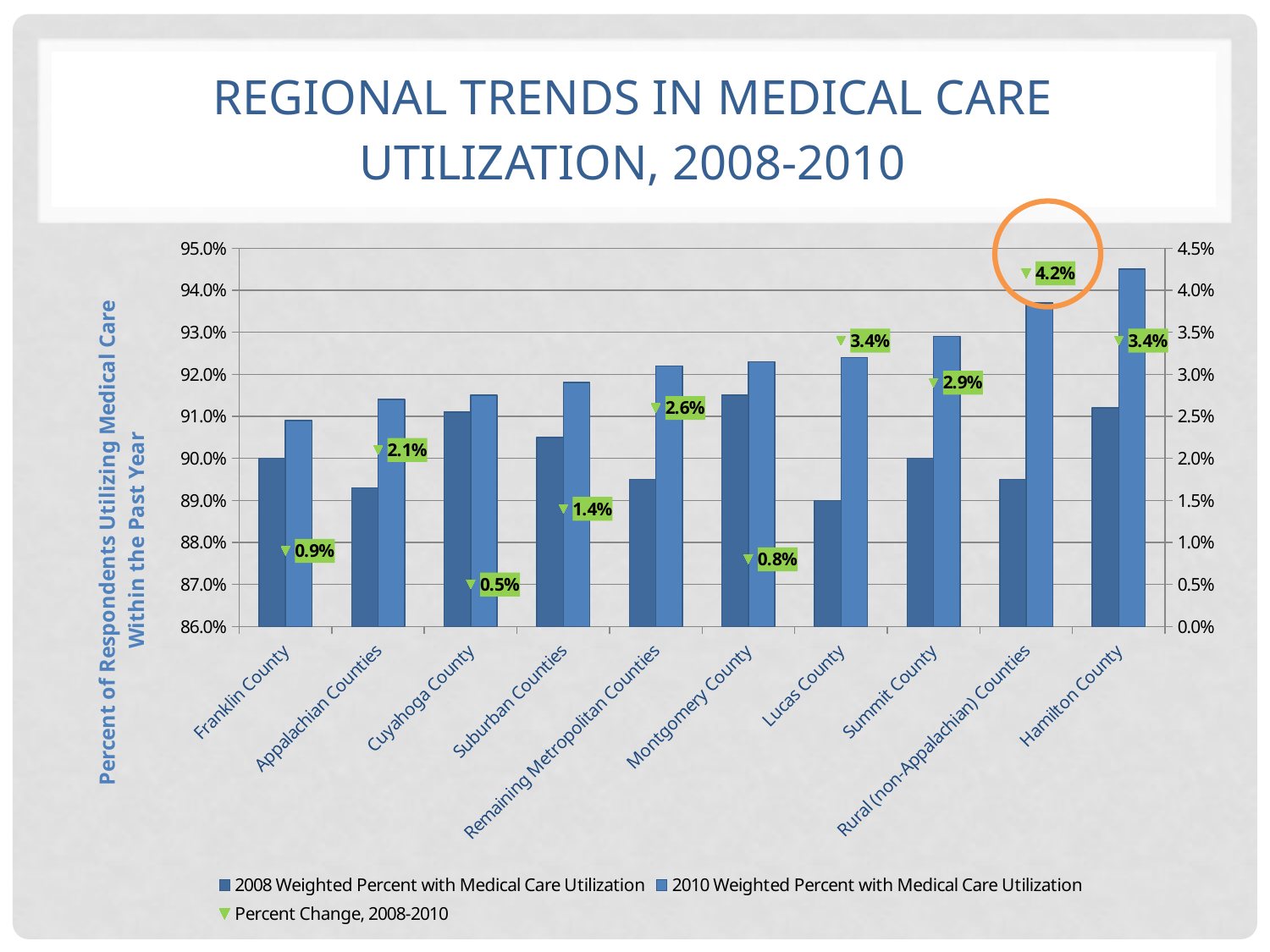
Which has a larger Percent Change, 2008-2010: Lucas County or Summit County? Lucas County What is the Percent Change, 2008-2010 for Rural (non-Appalachian) Counties? 4.2% What is the difference between the Percent Change for Rural (non-Appalachian) Counties and Cuyahoga County? 3.7% Which category has the lowest Percent Change, 2008-2010? Cuyahoga County How many series does the legend list? 3 Is the 2010 Weighted Percent with Medical Care Utilization for Hamilton County greater or less than 94.0%? greater What is the Percent Change, 2008-2010 for Cuyahoga County? 0.5% Is the 2008 Weighted Percent with Medical Care Utilization for Rural (non-Appalachian) Counties greater or less than 90.0%? less Which category has the highest Percent Change, 2008-2010? Rural (non-Appalachian) Counties What is the Percent Change, 2008-2010 for Remaining Metropolitan Counties? 2.6% What kind of chart is shown on the slide? bar chart How many categories are shown on the x axis? 10